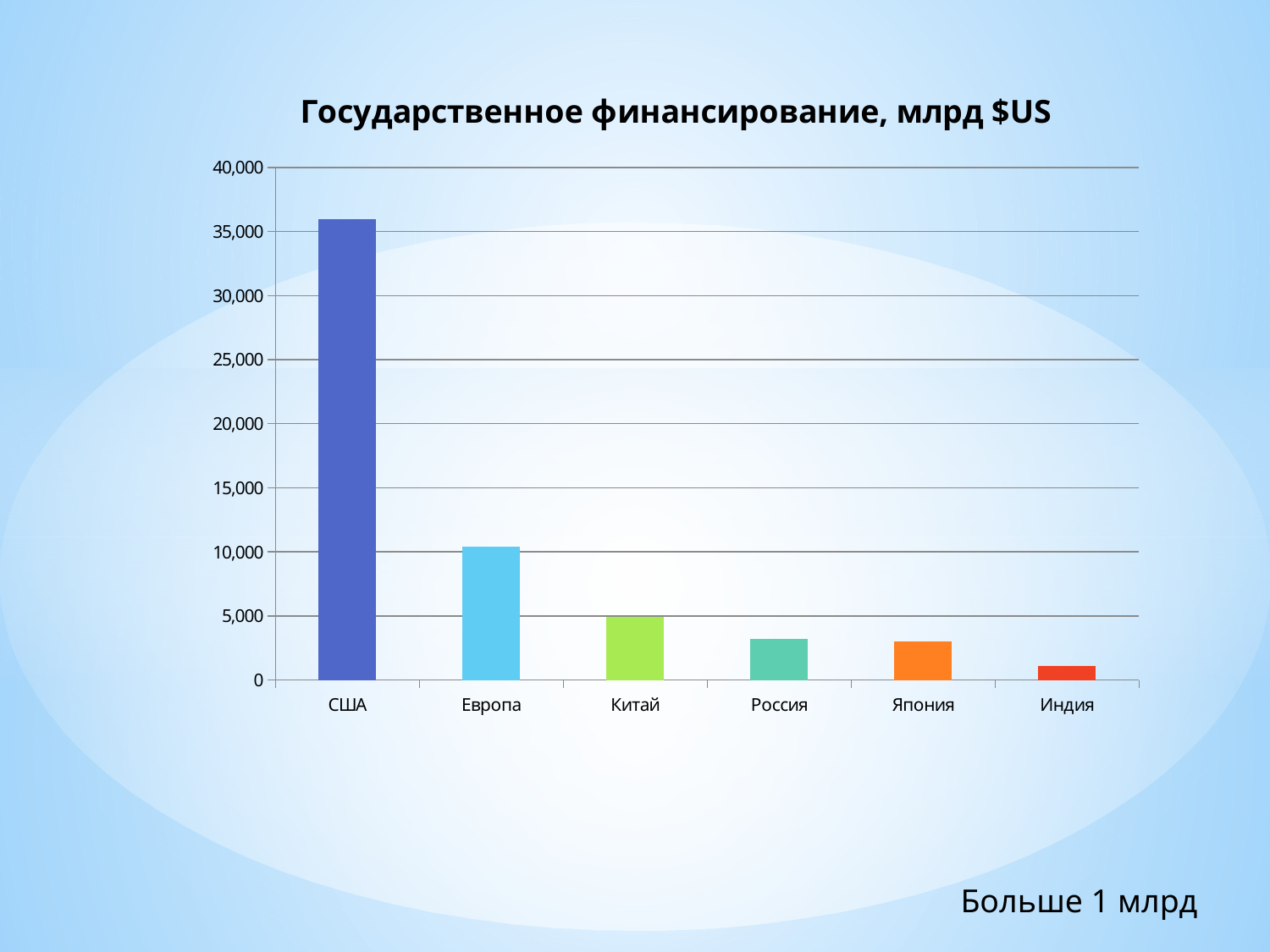
Which category has the lowest value in the chart? Индия Which is larger, the value for Европа or the value for Китай? Европа What kind of chart is shown on the slide? bar chart Which category has the highest value in the chart? США Do the values rise or fall from left to right along the x axis? fall What is the title of the chart? Государственное финансирование, млрд $US Is the value for США greater or less than 35,000? greater How many categories are shown on the x axis of the chart? 6 Which is larger, the value for Япония or the value for Индия? Япония Is the value for Индия greater or less than 5,000? less